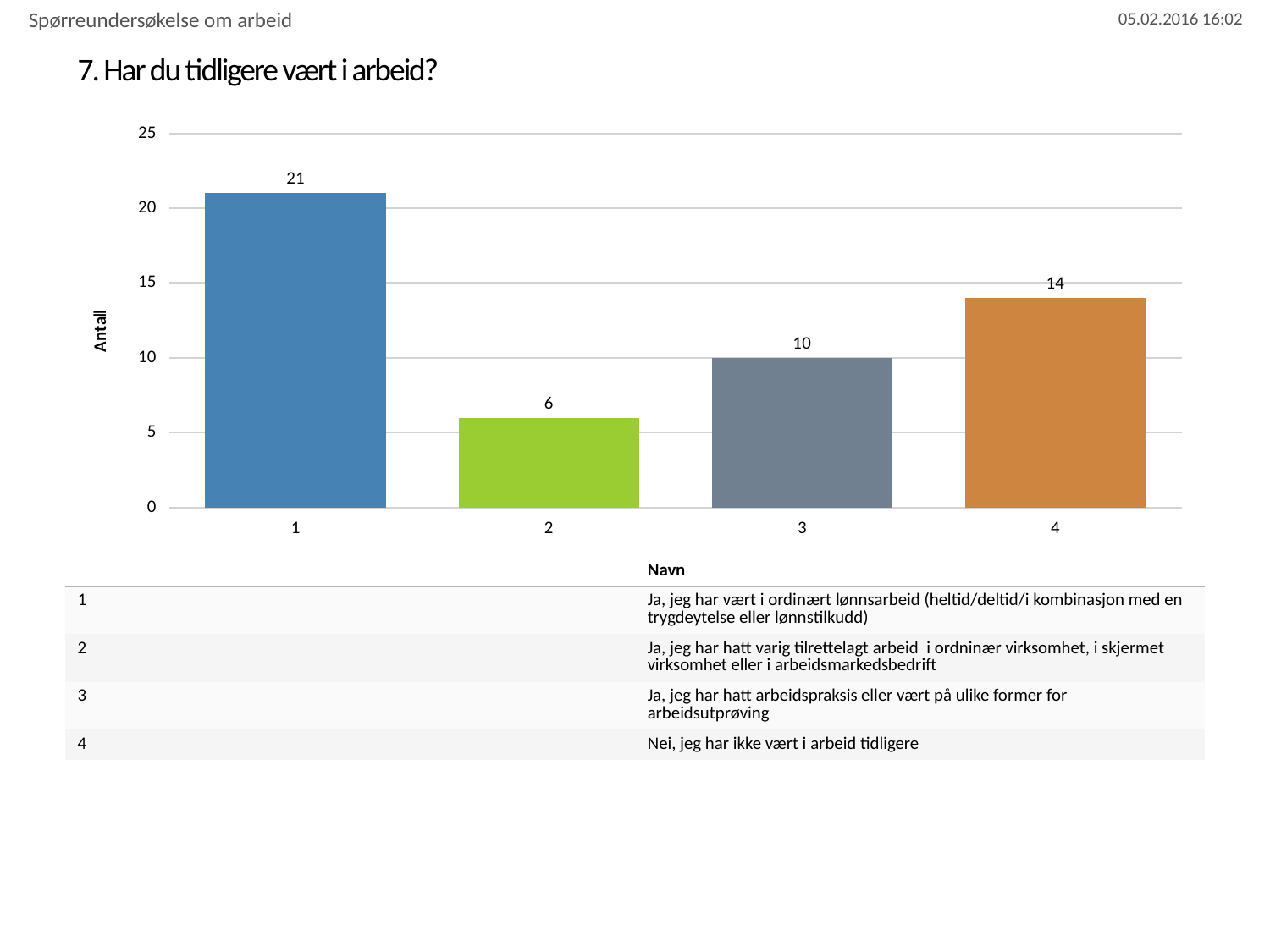
What is the value for category 3? 10 What is the difference between the values for category 3 and category 2? 4 What is the value for category 4 (Nei, jeg har ikke vært i arbeid tidligere)? 14 How many categories are shown on the x axis? 4 Which category has the highest value? 1 What is the value for category 2? 6 What is the label of the y axis? Antall Which category has the lowest value? 2 What kind of chart is shown on the slide? bar chart What is the value for category 1? 21 What is the difference between the values for category 1 and category 4? 7 Which is larger, the value for category 3 or the value for category 4? category 4